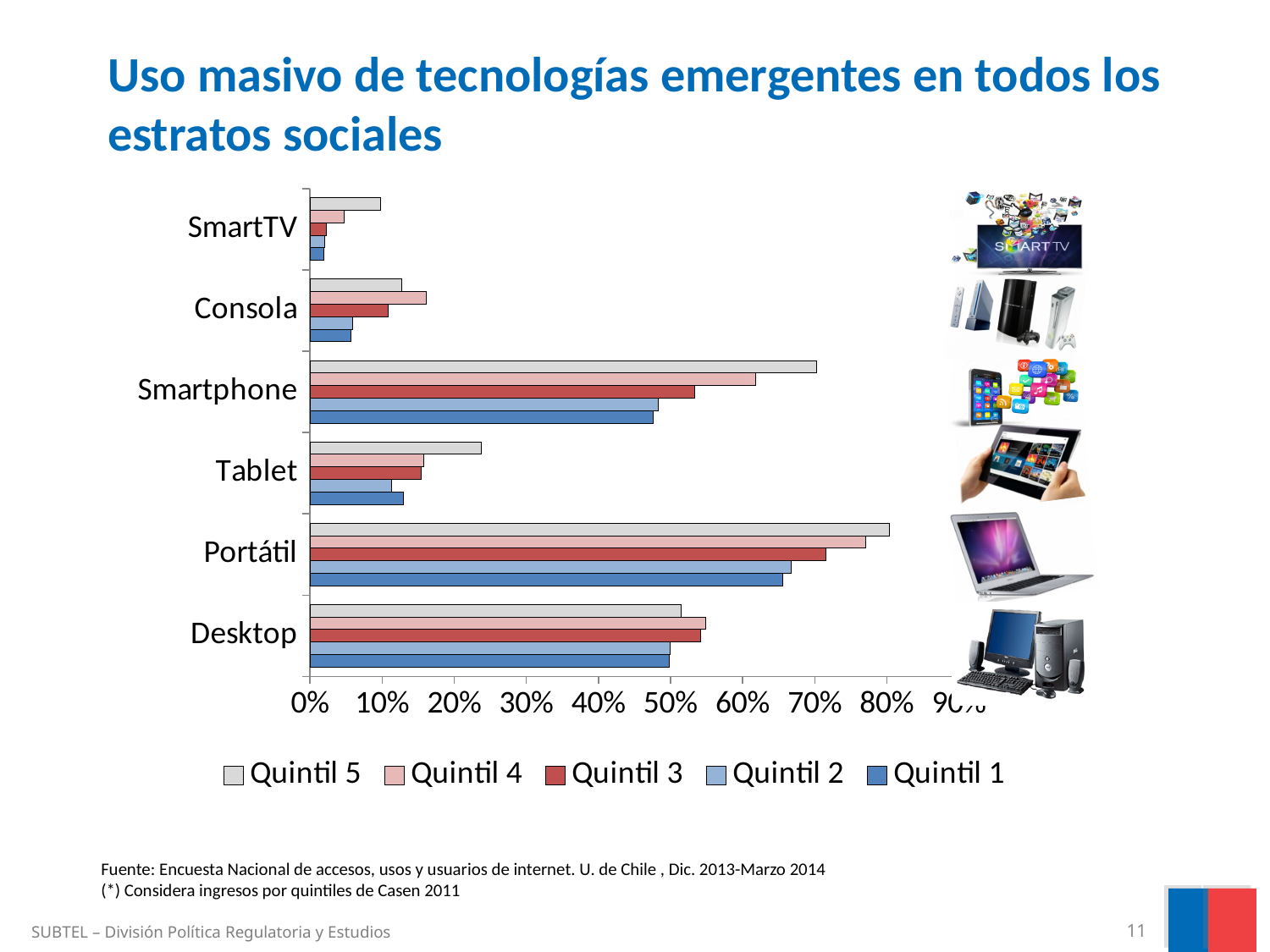
Is the value for Quintil 1 in the Portátil category greater or less than 60%? greater In the Smartphone category, which is larger: the value for Quintil 5 or for Quintil 1? Quintil 5 How many device categories are shown on the chart? 6 Is the value for Quintil 1 in the SmartTV category greater or less than 10%? less What kind of chart is shown on the slide? bar chart For Quintil 5, which is larger: the value for Portátil or for Desktop? Portátil Is the value for Quintil 5 in the Tablet category greater or less than 30%? less How many series does the legend list? 5 Which series is listed first in the chart legend? Quintil 5 Which category has the highest value for Quintil 5? Portátil Which category has the lowest value for Quintil 5? SmartTV